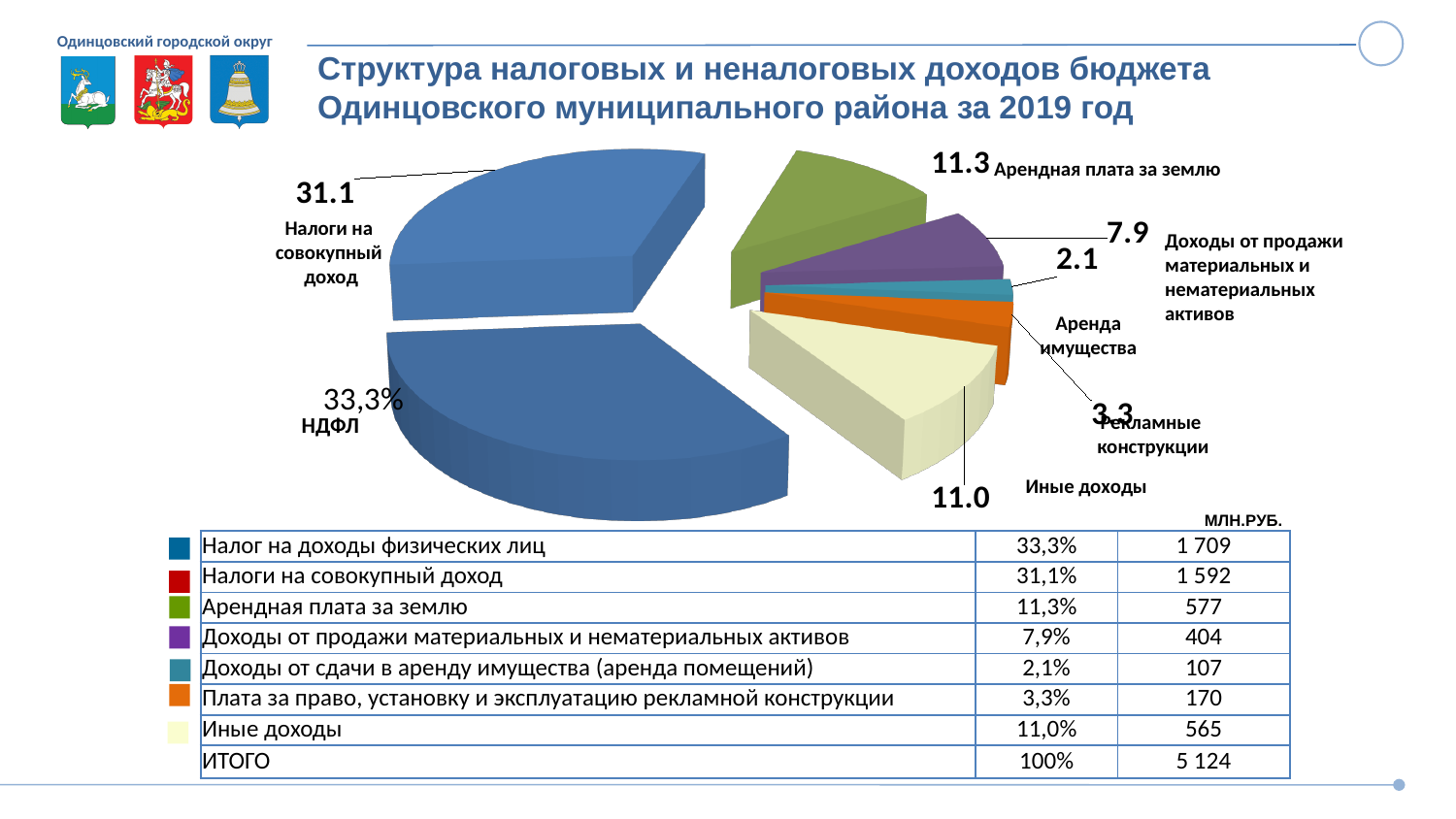
What value is printed on the pie for Иные доходы? 11.0 What value is printed on the pie for Аренда имущества? 2.1 What value is printed on the pie for Налоги на совокупный доход? 31.1 Which slice of the pie is the largest? НДФЛ What colour is the slice for Арендная плата за землю? Green How many slices does the pie chart have? 7 Which is larger on the pie: Арендная плата за землю or Иные доходы? Арендная плата за землю What share of the pie is labelled for НДФЛ? 33,3% What kind of chart is shown on the slide? Pie chart What is the difference between the pie values for Налоги на совокупный доход (31.1) and Доходы от продажи материальных и нематериальных активов (7.9)? 23.2 What value is printed on the pie for Арендная плата за землю? 11.3 Which slice of the pie is the smallest? Аренда имущества